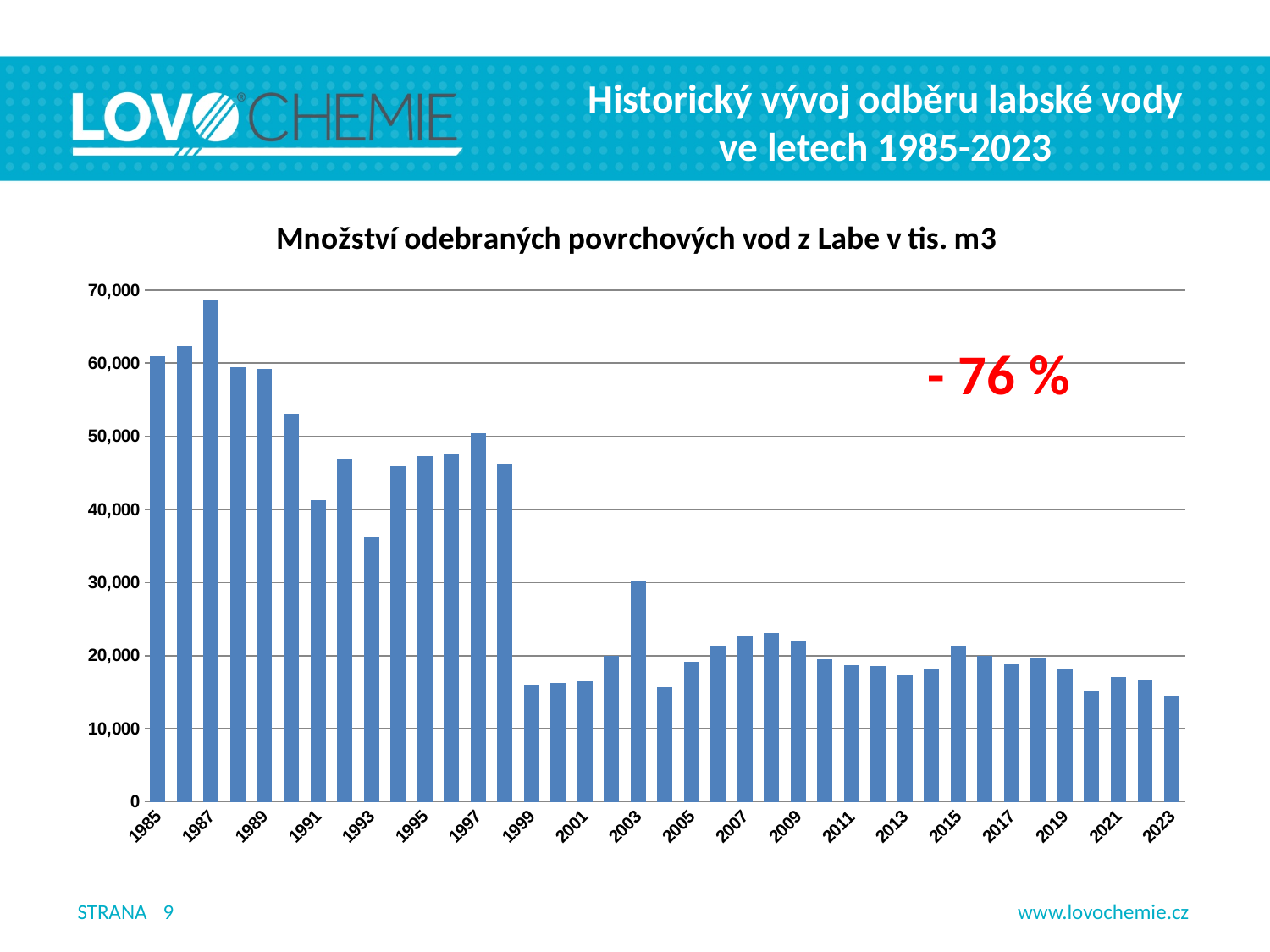
Which is larger, the value for 1997 or the value for 1999? 1997 Is the value for 1993 greater or less than 40,000? less Is the value for 1987 greater or less than 60,000? greater Which is larger, the value for 2003 or the value for 2005? 2003 Do the values generally rise or fall from 1985 to 2023? fall What kind of chart is shown on the slide? bar chart Is the value for 2007 greater or less than 20,000? greater How many bars (years) are plotted in the chart? 39 What is the title of the chart? Množství odebraných povrchových vod z Labe v tis. m3 Which year has the highest value in the chart? 1987